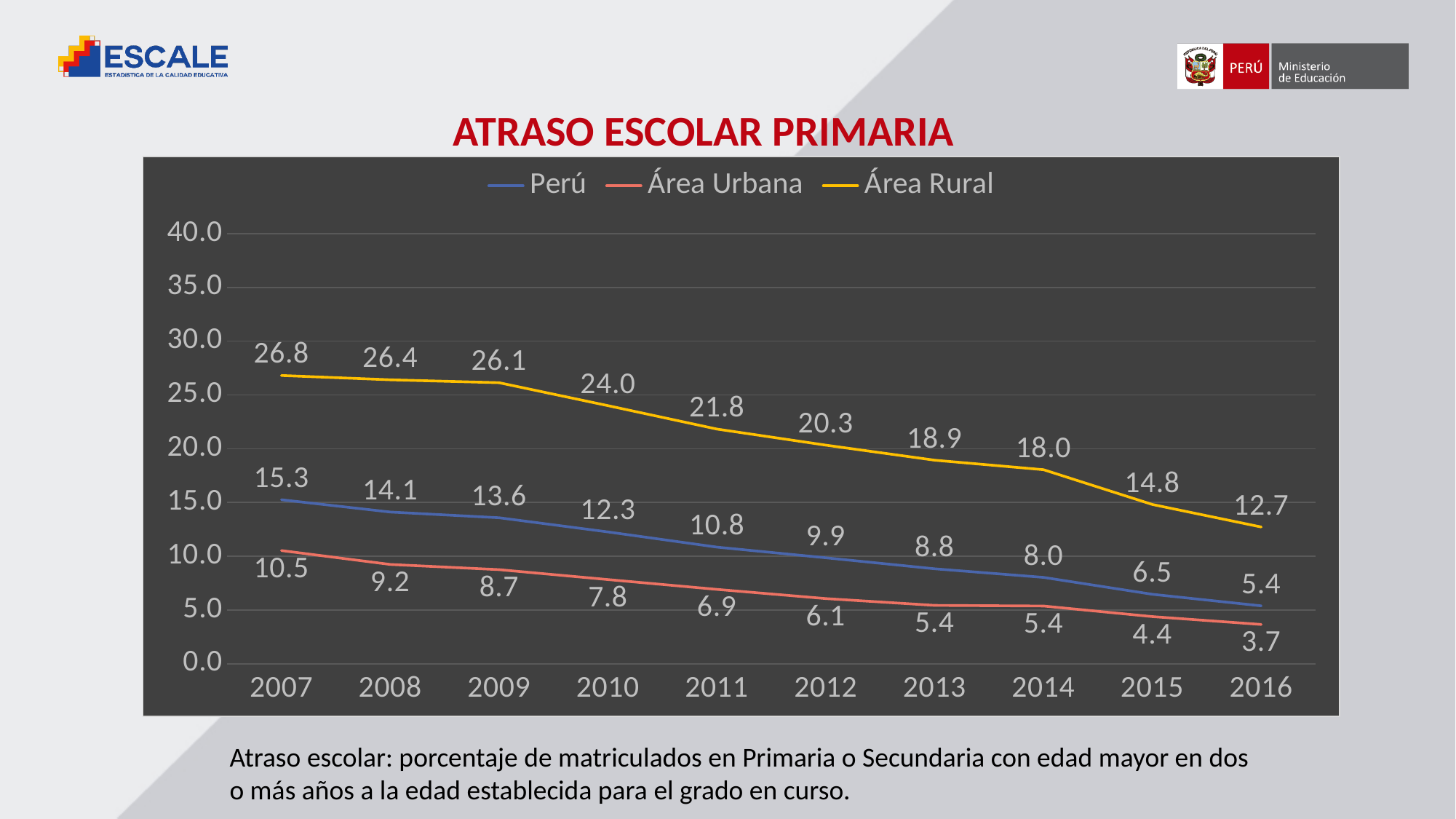
In which year is the Perú value highest? 2007 In which year is the Área Rural value lowest? 2016 How many years are shown on the x axis? 10 How many series does the legend list? 3 What kind of chart is shown on the slide? line chart Do the Perú values rise or fall from 2007 to 2016? fall What is the value for Área Rural in 2007? 26.8 What is the value for Área Urbana in 2010? 7.8 What is the value for Perú in 2016? 5.4 Which is larger in 2012: the Perú value or the Área Urbana value? Perú Is the Área Rural value in 2011 greater or less than 20.0? greater What is the difference between the Área Rural and Área Urbana values in 2016? 9.0